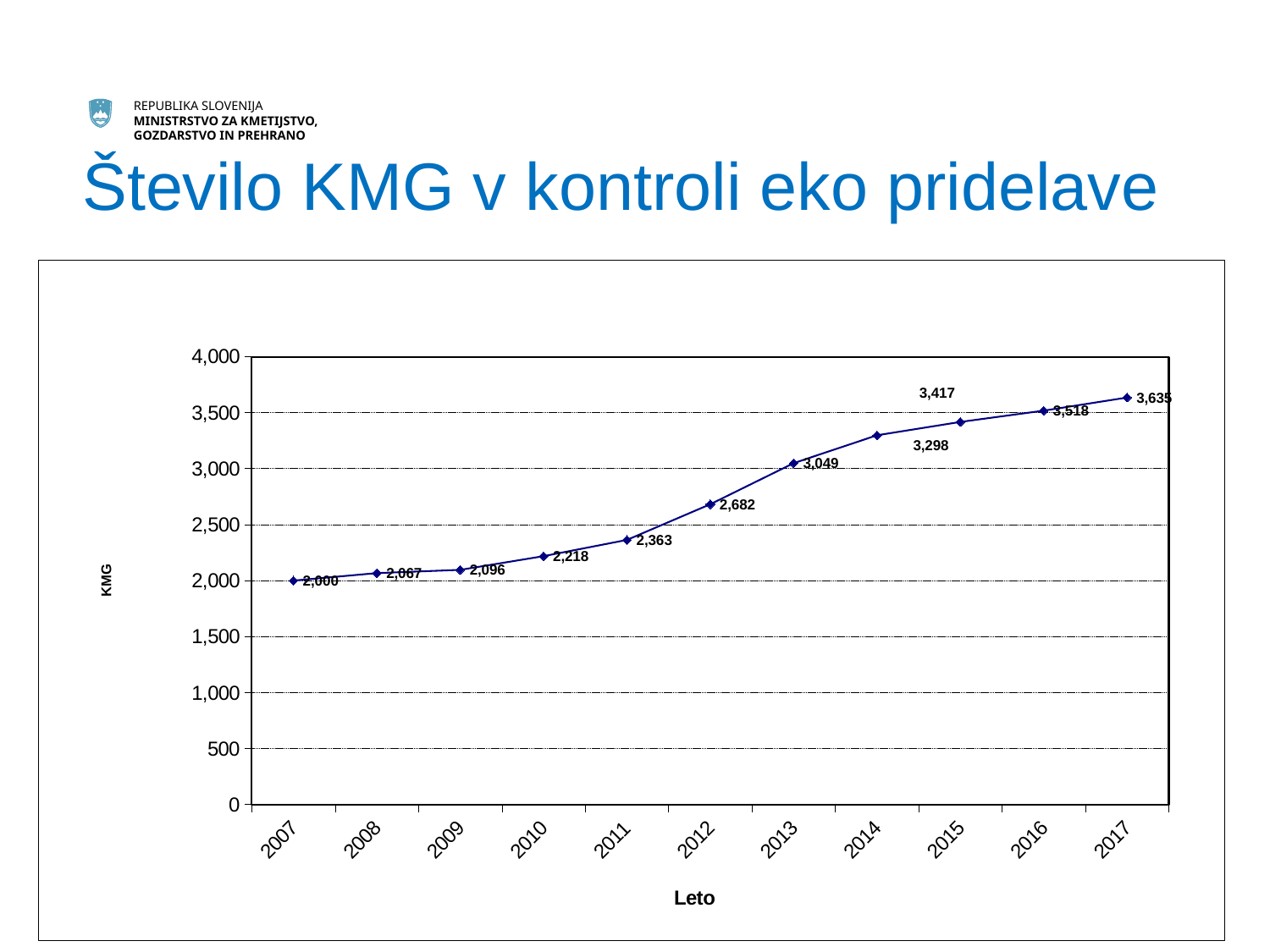
What is the value for 2007? 2,000 Which year has the lowest value? 2007 What is the value for 2017? 3,635 How many years are plotted on the x axis? 11 What is the value for 2012? 2,682 What type of chart is shown on the slide? Line chart What is the value for 2015? 3,417 Which is larger, the value for 2014 or the value for 2011? 2014 Which year has the highest value? 2017 What is the difference between the values for 2017 and 2007? 1,635 Do the values rise or fall from 2007 to 2017? Rise What is the difference between the values for 2013 and 2012? 367